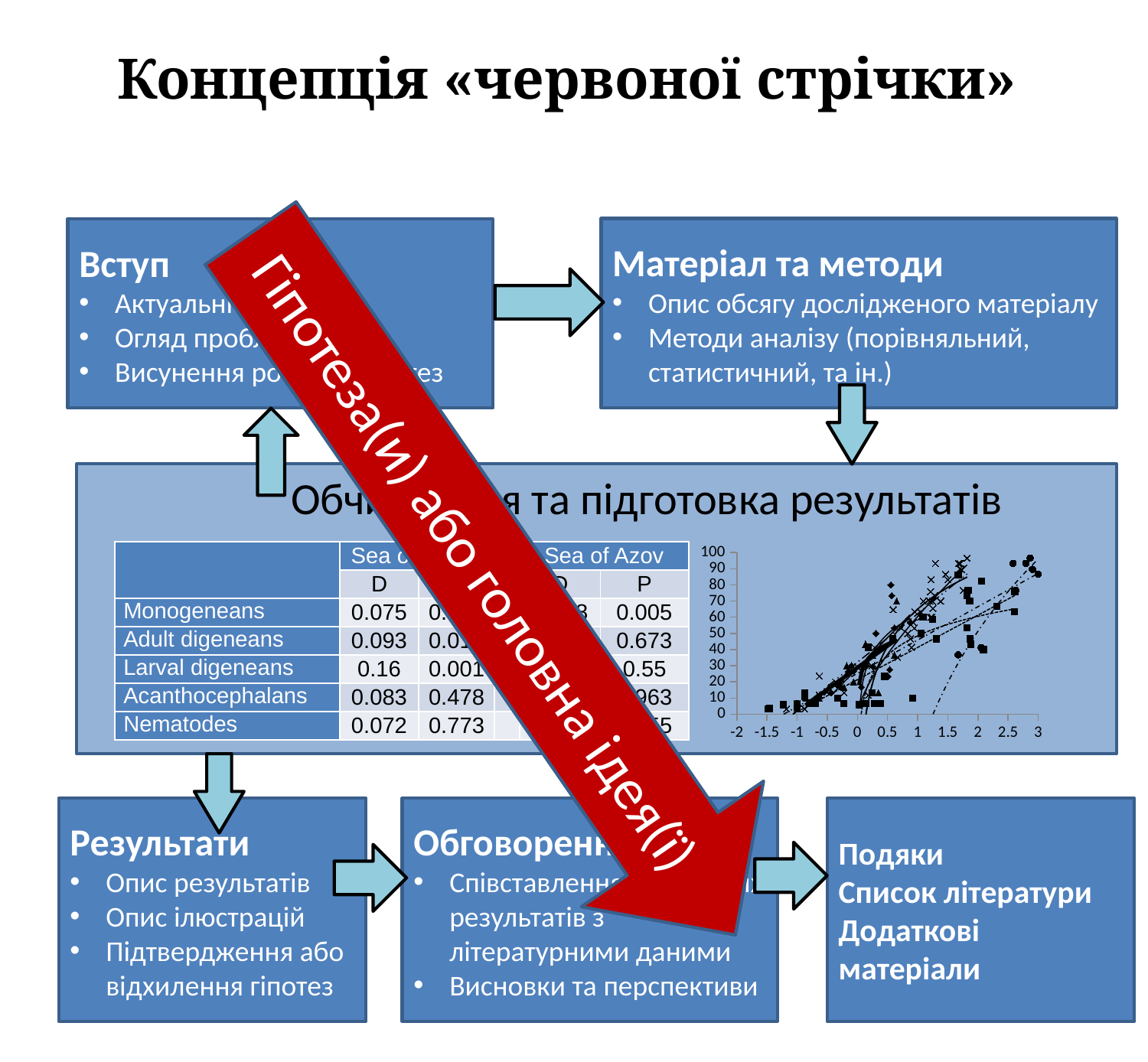
In the scatter chart on the slide, do the plotted values generally rise or fall as the x-axis value increases? rise What are the lowest and highest tick values shown on the x axis of the scatter chart on the slide? -2 and 3 What kind of chart is shown on the right side of the middle panel of the slide? scatter chart What is the highest tick value shown on the y axis of the scatter chart on the slide? 100